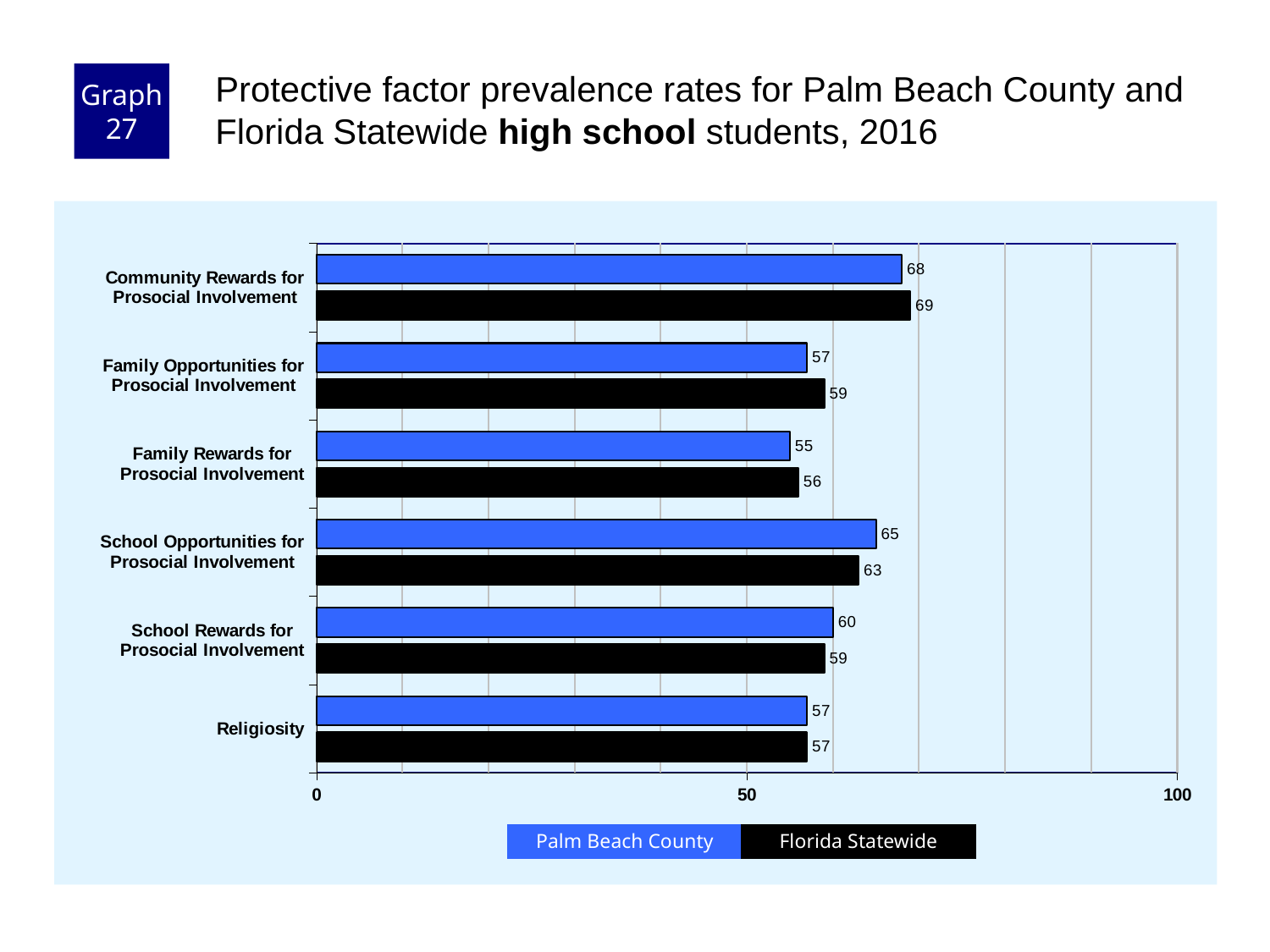
For School Rewards for Prosocial Involvement, which is larger: Palm Beach County or Florida Statewide? Palm Beach County Which category has the lowest Palm Beach County value? Family Rewards for Prosocial Involvement How many series does the legend list? 2 What is the difference between the Florida Statewide and Palm Beach County values for School Opportunities for Prosocial Involvement? 2 What kind of chart is shown on the slide? Bar chart How many categories are shown on the chart? 6 Which category has the highest Florida Statewide value? Community Rewards for Prosocial Involvement What is the Florida Statewide value for Family Opportunities for Prosocial Involvement? 59 What is the Palm Beach County value for School Opportunities for Prosocial Involvement? 65 What is the Palm Beach County value for Community Rewards for Prosocial Involvement? 68 Is the Palm Beach County value for Religiosity greater or less than 50? greater Which colour represents Florida Statewide in the chart? Black